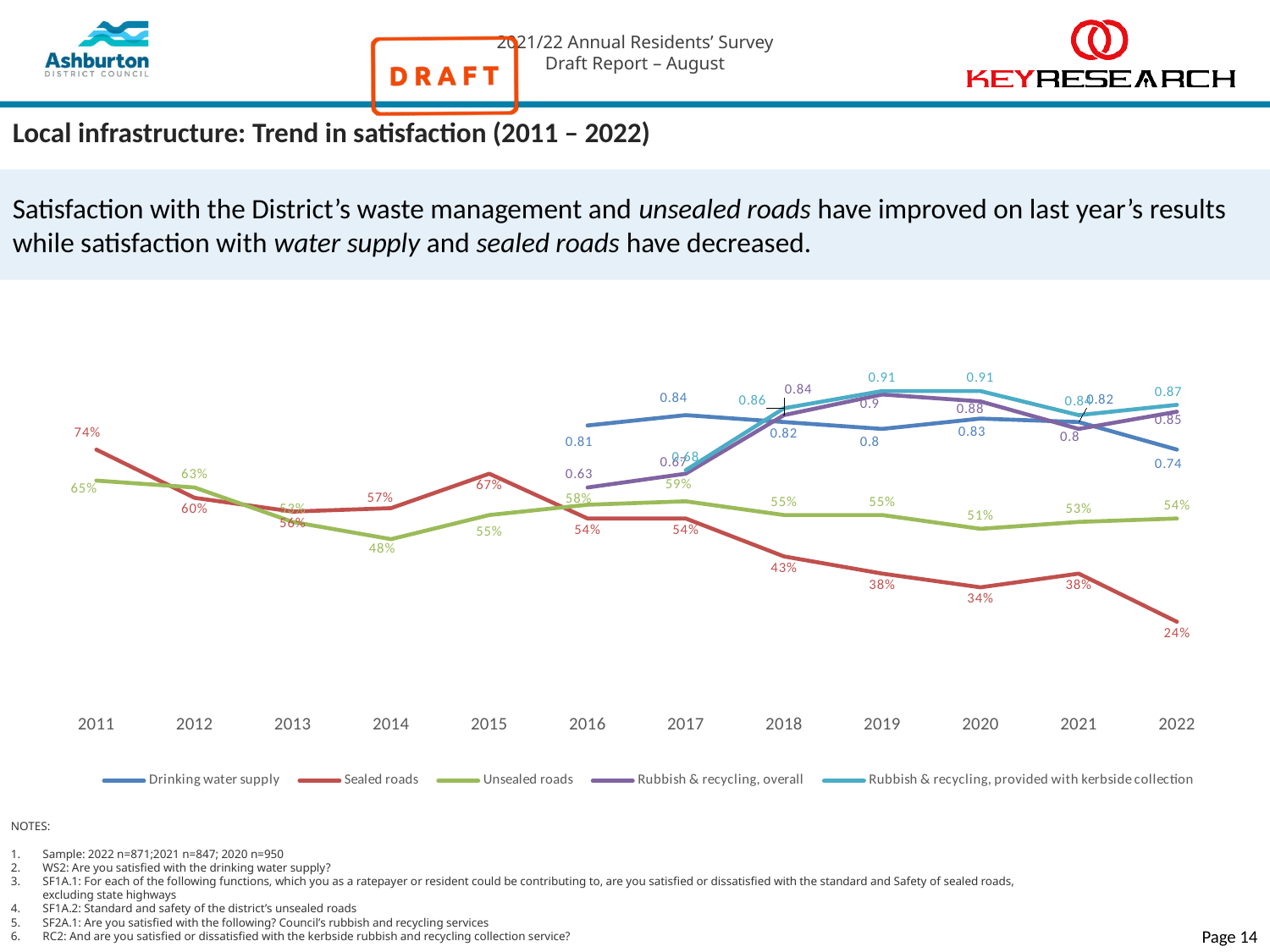
How many years are shown along the x axis? 12 What was the satisfaction value for Unsealed roads in 2014? 48% Does satisfaction with Sealed roads rise or fall overall from 2011 to 2022? Fall How many series does the legend list? 5 What kind of chart is shown on the slide? Line chart What was the value for Rubbish & recycling, provided with kerbside collection in 2019? 0.91 What was the value for Drinking water supply in 2022? 0.74 What was the satisfaction value for Sealed roads in 2011? 74% By how many percentage points did Sealed roads satisfaction change from 2021 (38%) to 2022 (24%)? 14 percentage points What was the satisfaction value for Sealed roads in 2022? 24% What was the satisfaction value for Unsealed roads in 2022? 54% In which year was satisfaction with Sealed roads lowest? 2022